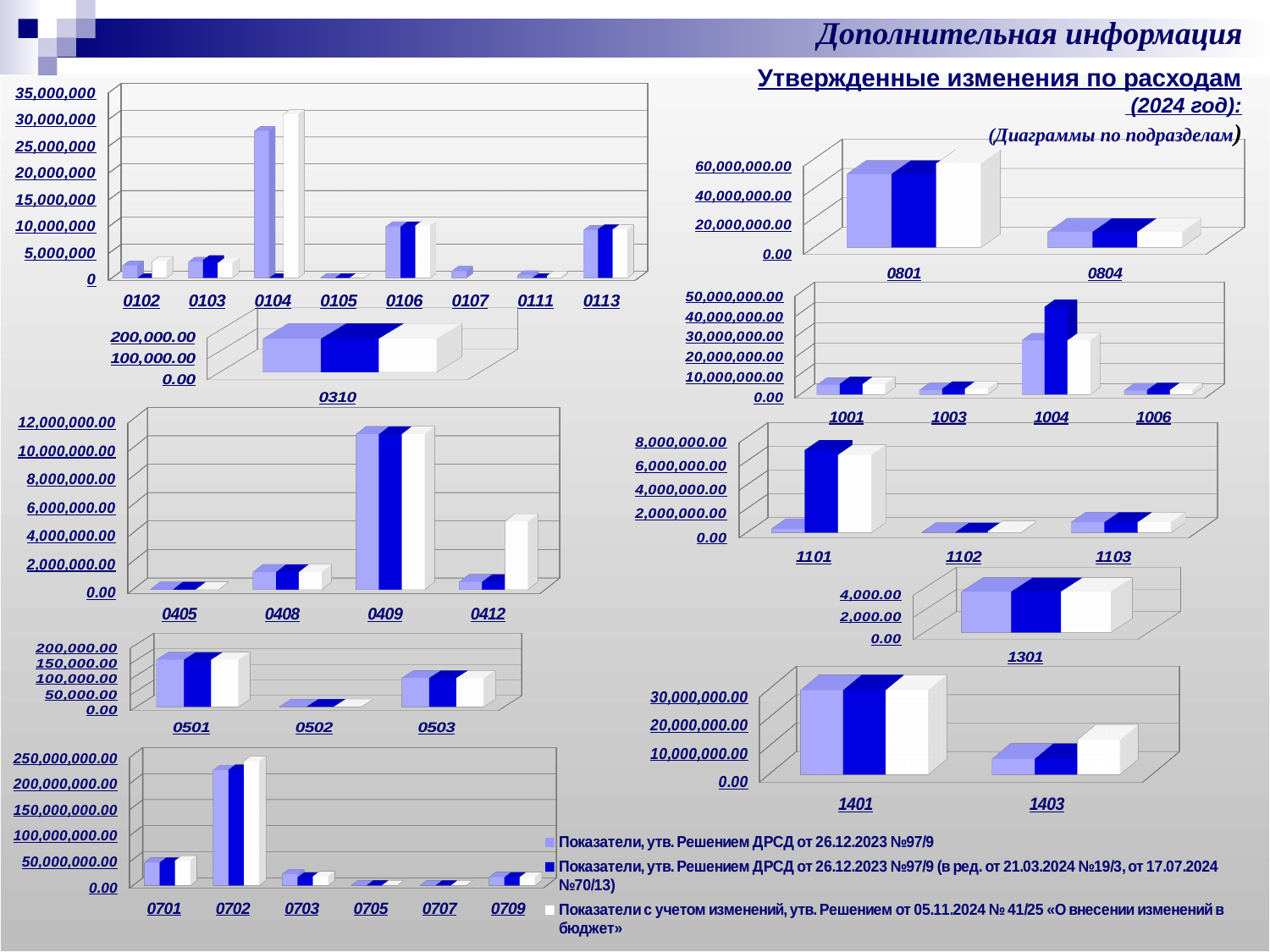
In the chart with categories 0801 and 0804, which category has larger values? 0801 In the chart with categories 0701 to 0709, which category has the highest values? 0702 In the chart with categories 0405 to 0412, which category has the highest values? 0409 In the top-left chart (0102 to 0113), which category has the highest value? 0104 How many categories are shown in the top-left chart (0102 to 0113)? 8 In the chart with categories 1401 and 1403, which category has larger values? 1401 In the chart with categories 0701 to 0709, is the value for 0702 greater or less than 150,000,000.00? greater How many categories are shown in the chart with categories 0701 to 0709? 6 How many series does the legend list? 3 What kind of chart is the chart with categories 0701 to 0709? bar chart In the chart with categories 0801 and 0804, is the value for 0804 greater or less than 40,000,000.00? less